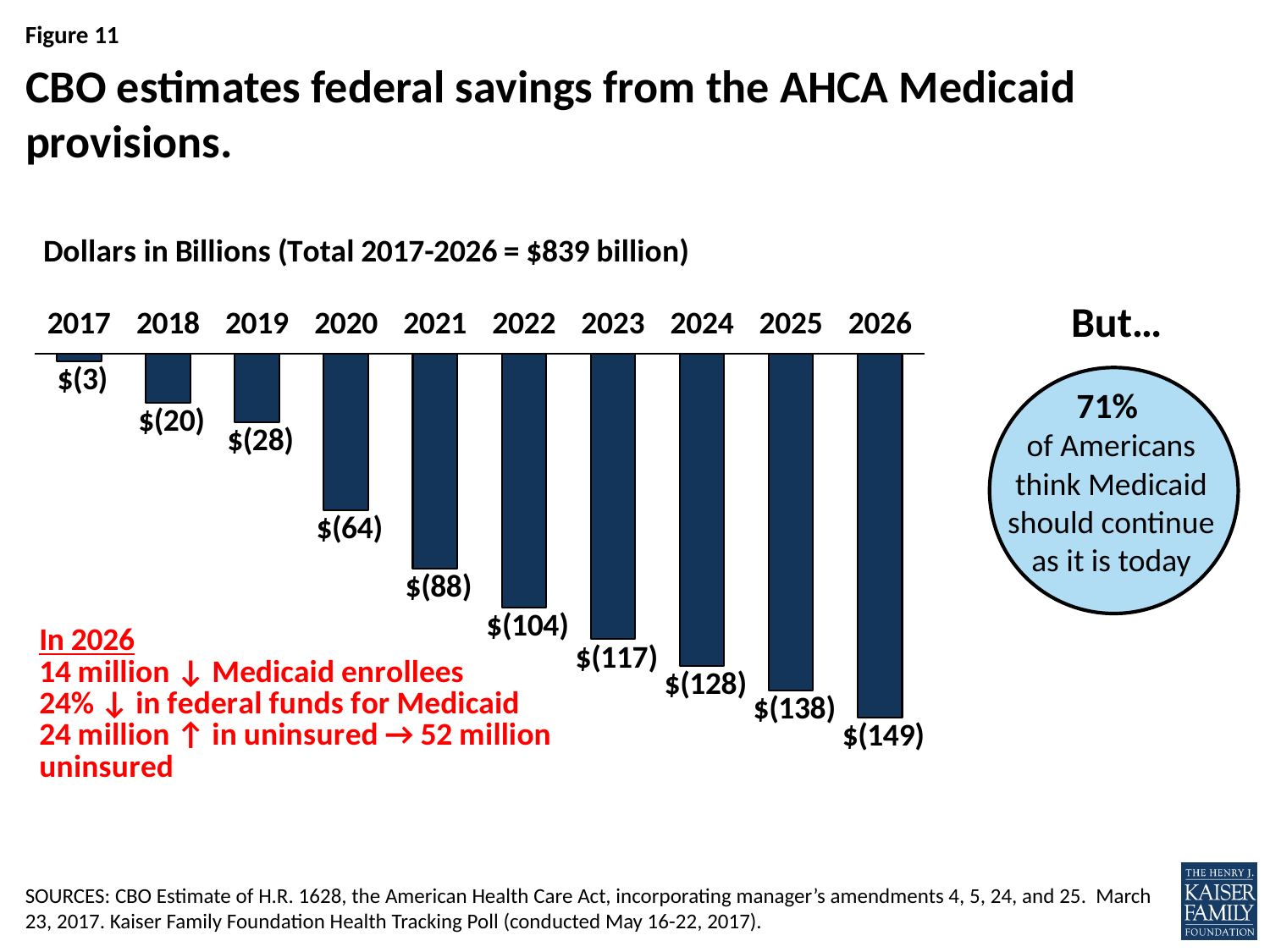
What total for 2017-2026 is stated in the chart subtitle? $839 billion What kind of chart is used to show the savings by year? Bar chart What is the value shown for 2017? $(3) Which year has the largest savings (longest bar)? 2026 Which year has a longer bar, 2021 or 2022? 2022 What is the difference in billions between the 2026 value and the 2025 value? 11 What is the value shown for 2020? $(64) What is the value shown for 2023? $(117) How many years are shown on the chart? 10 Which year has the smallest savings (shortest bar)? 2017 What is the value shown for 2026? $(149) Do the savings amounts increase or decrease from 2017 to 2026? Increase